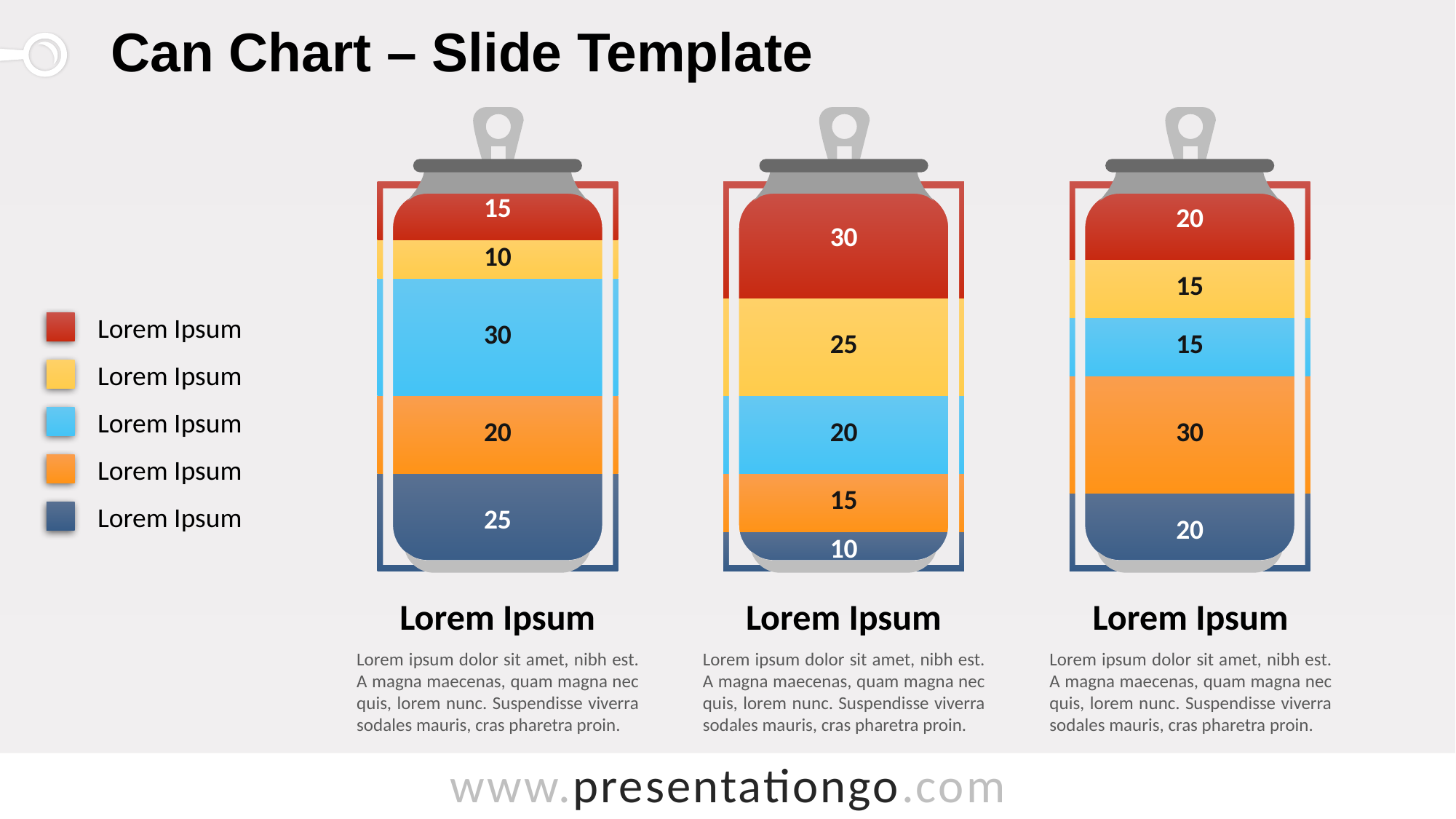
What is the total of all segments in the middle can chart? 100 In the right can chart, what is the value of the orange segment? 30 In the left can chart, which coloured segment has the smallest value? Yellow In the left can chart, what is the value of the dark blue segment at the bottom? 25 How many entries does the legend list? 5 In the middle can chart, what is the value of the yellow segment? 25 Which is larger: the light blue segment in the left can chart or the light blue segment in the right can chart? The left can chart In the right can chart, what is the difference between the orange segment and the yellow segment? 15 In the left can chart, what is the value of the red segment? 15 In the middle can chart, which coloured segment has the largest value? Red How many segments does each can chart contain? 5 What is the title of the slide? Can Chart – Slide Template